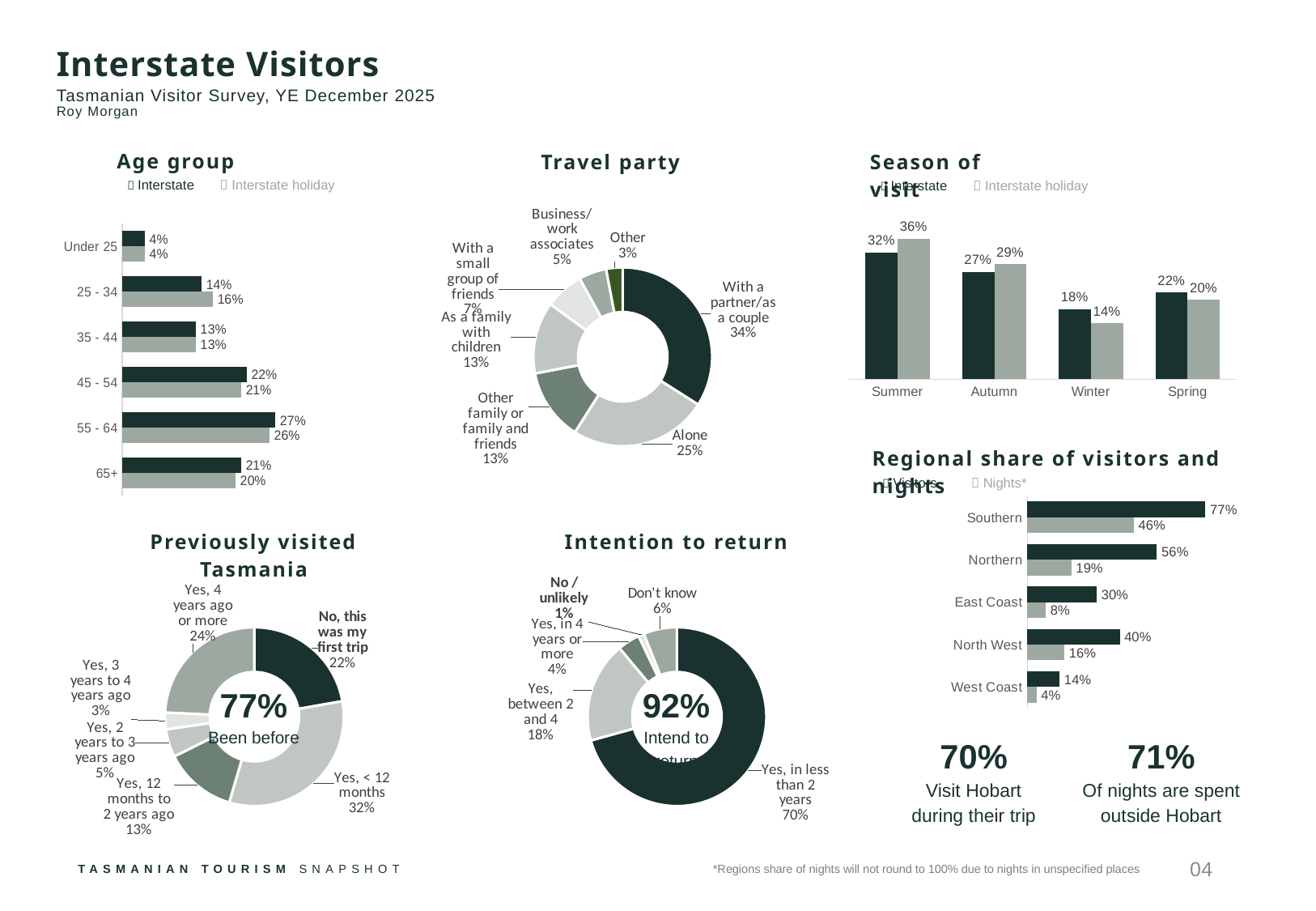
In the Age group chart, how many age groups are shown? 6 In the Age group chart, which age group has the lowest Interstate value? Under 25 In the Season of visit chart, which season has the highest Interstate value? Summer In the Season of visit chart, what is the difference between the Interstate and Interstate holiday values for Winter? 4% In the Travel party chart, what share of visitors travel with a partner/as a couple? 34% In the Previously visited Tasmania chart, what share of visitors said this was their first trip? 22% In the Season of visit chart, what is the Interstate holiday value for Summer? 36% In the Regional share of visitors and nights chart, what is the Nights value for Southern? 46% In the Regional share of visitors and nights chart, which region has the lowest Visitors value? West Coast In the Intention to return chart, what share of visitors intend to return in less than 2 years? 70% In the Age group chart, what is the Interstate value for the 55 - 64 age group? 27% In the Travel party chart, which travel party category has the smallest share? Other